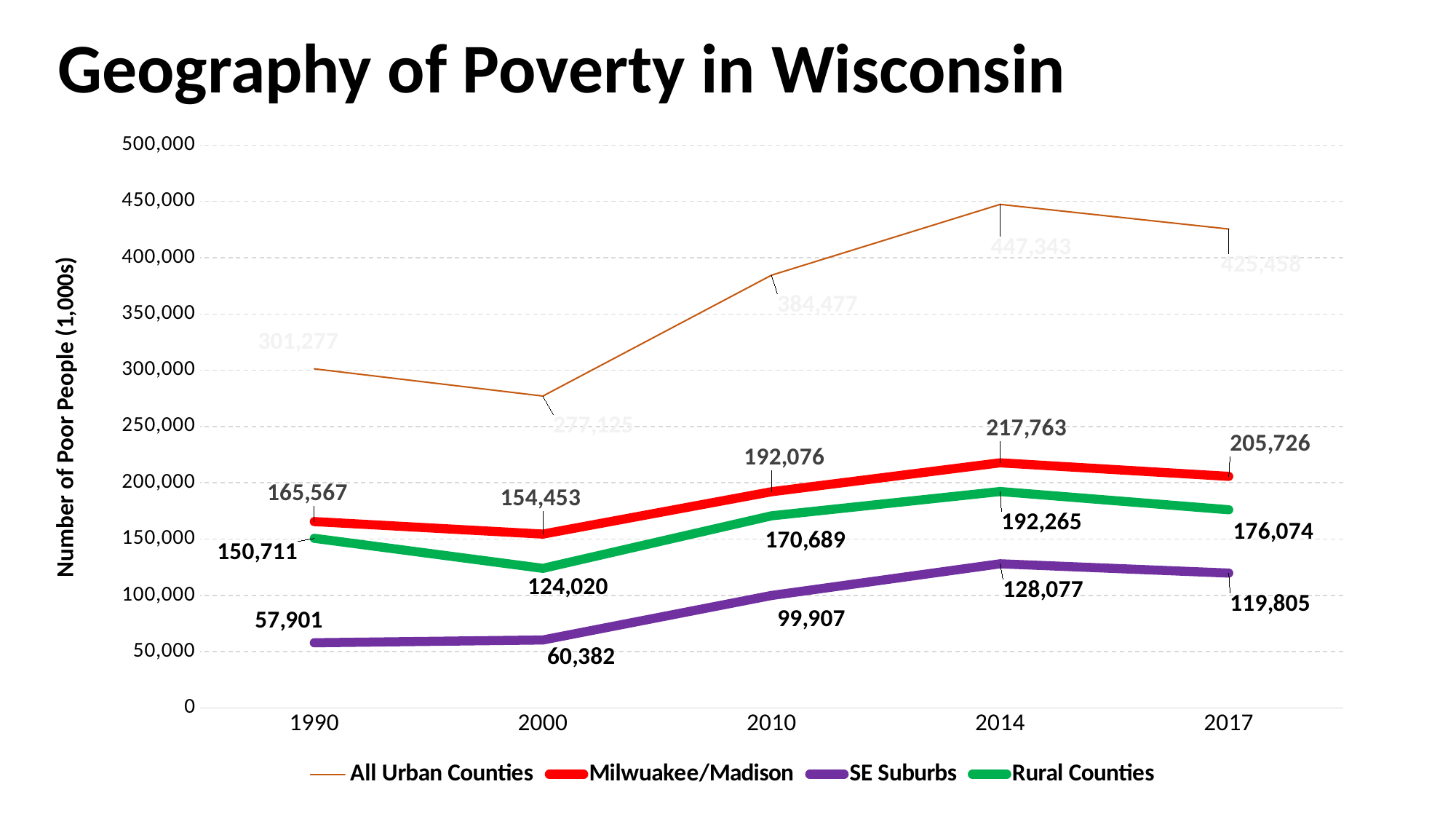
In which year is the Rural Counties value lowest? 2000 Which series has the larger value in 2010, SE Suburbs or Rural Counties? Rural Counties What is the difference between the Milwuakee/Madison value and the Rural Counties value in 2017? 29,652 What is the label of the y axis? Number of Poor People (1,000s) In which year is the SE Suburbs value highest? 2014 What is the value for Milwuakee/Madison in 2014? 217,763 What is the value for SE Suburbs in 1990? 57,901 What type of chart is shown on the slide? line chart How many years are plotted along the x axis? 5 How many series does the legend list? 4 What is the value for Rural Counties in 2000? 124,020 Is the value for All Urban Counties in 2014 greater or less than 400,000? greater